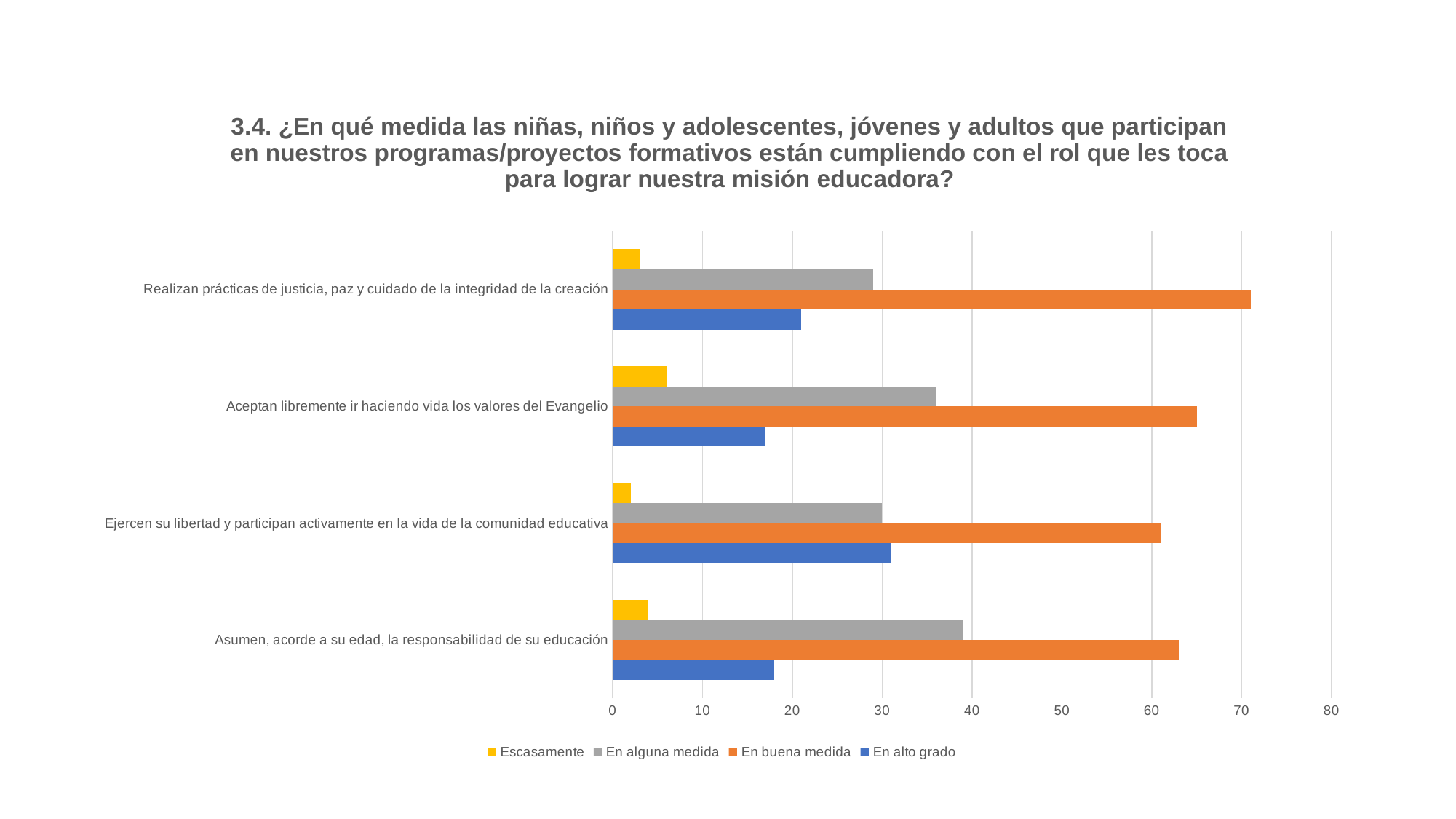
How many categories (statements) are plotted on the chart? 4 Which category has the highest value for 'En buena medida'? Realizan prácticas de justicia, paz y cuidado de la integridad de la creación Which category has the highest value for 'En alto grado'? Ejercen su libertad y participan activamente en la vida de la comunidad educativa Which has the larger 'Escasamente' value: 'Aceptan libremente ir haciendo vida los valores del Evangelio' or 'Ejercen su libertad y participan activamente en la vida de la comunidad educativa'? Aceptan libremente ir haciendo vida los valores del Evangelio How many series does the legend list? 4 Is the 'En buena medida' value for 'Realizan prácticas de justicia, paz y cuidado de la integridad de la creación' greater or less than 60? greater Which has the larger 'En alguna medida' value: 'Asumen, acorde a su edad, la responsabilidad de su educación' or 'Realizan prácticas de justicia, paz y cuidado de la integridad de la creación'? Asumen, acorde a su edad, la responsabilidad de su educación What colour represents the 'En buena medida' series in the legend? orange Which category has the highest value for 'Escasamente'? Aceptan libremente ir haciendo vida los valores del Evangelio Is the 'En alto grado' value for 'Ejercen su libertad y participan activamente en la vida de la comunidad educativa' greater or less than 20? greater Is the 'En alguna medida' value for 'Asumen, acorde a su edad, la responsabilidad de su educación' greater or less than 30? greater What kind of chart is shown on the slide? bar chart